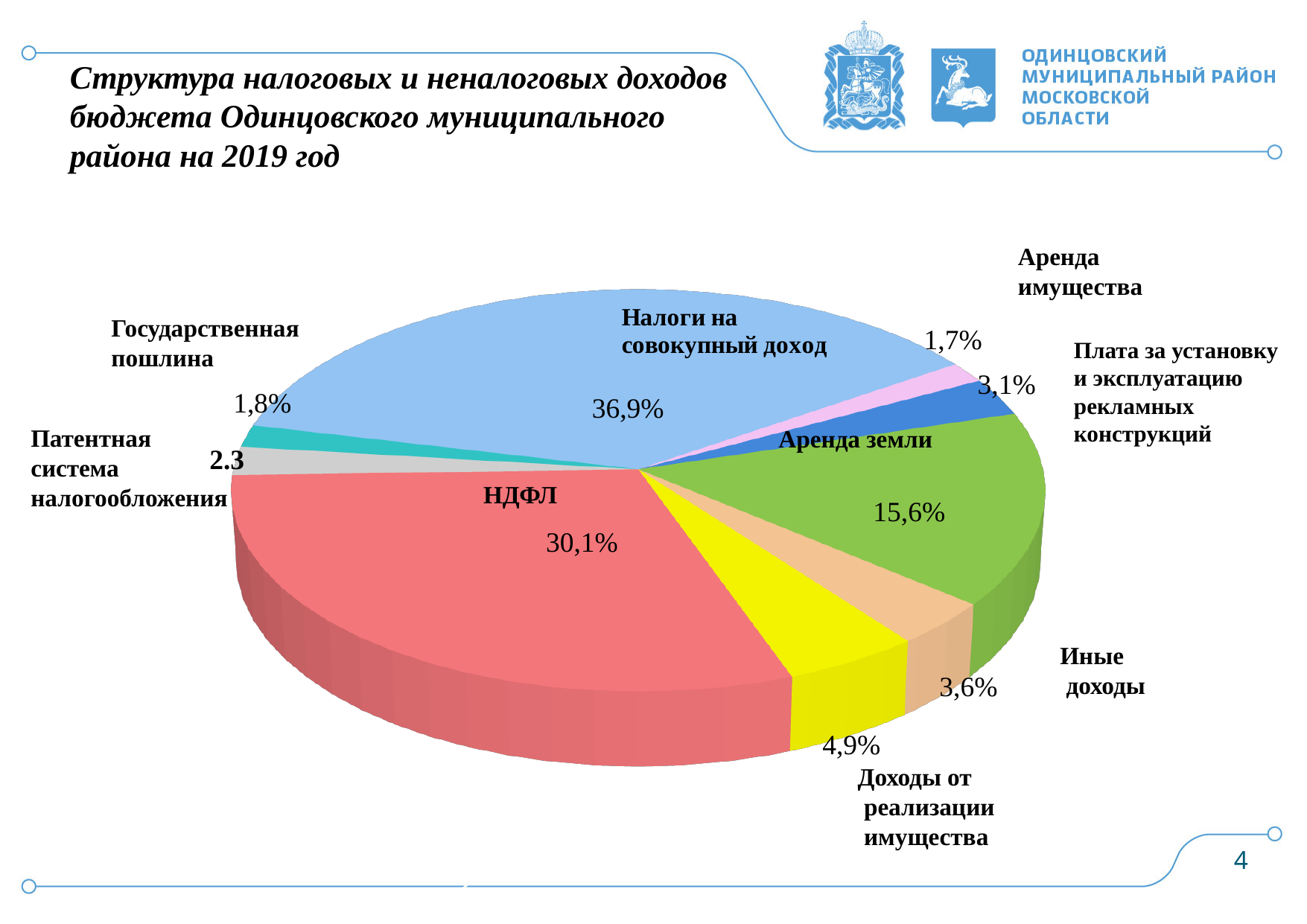
How many slices does the pie chart have? 9 What kind of chart is shown on the slide? pie chart What is the value shown for Аренда земли? 15,6% What colour is the slice for Аренда земли? green What is the value shown for Патентная система налогообложения? 2.3 Which is larger, the share of Иные доходы or the share of Доходы от реализации имущества? Доходы от реализации имущества What is the difference between the shares of Налоги на совокупный доход and НДФЛ? 6,8% Which category has the smallest share of the pie? Аренда имущества Which category has the largest share of the pie? Налоги на совокупный доход What is the value shown for Доходы от реализации имущества? 4,9% What share of the pie does НДФЛ have? 30,1% What is the value shown for Плата за установку и эксплуатацию рекламных конструкций? 3,1%